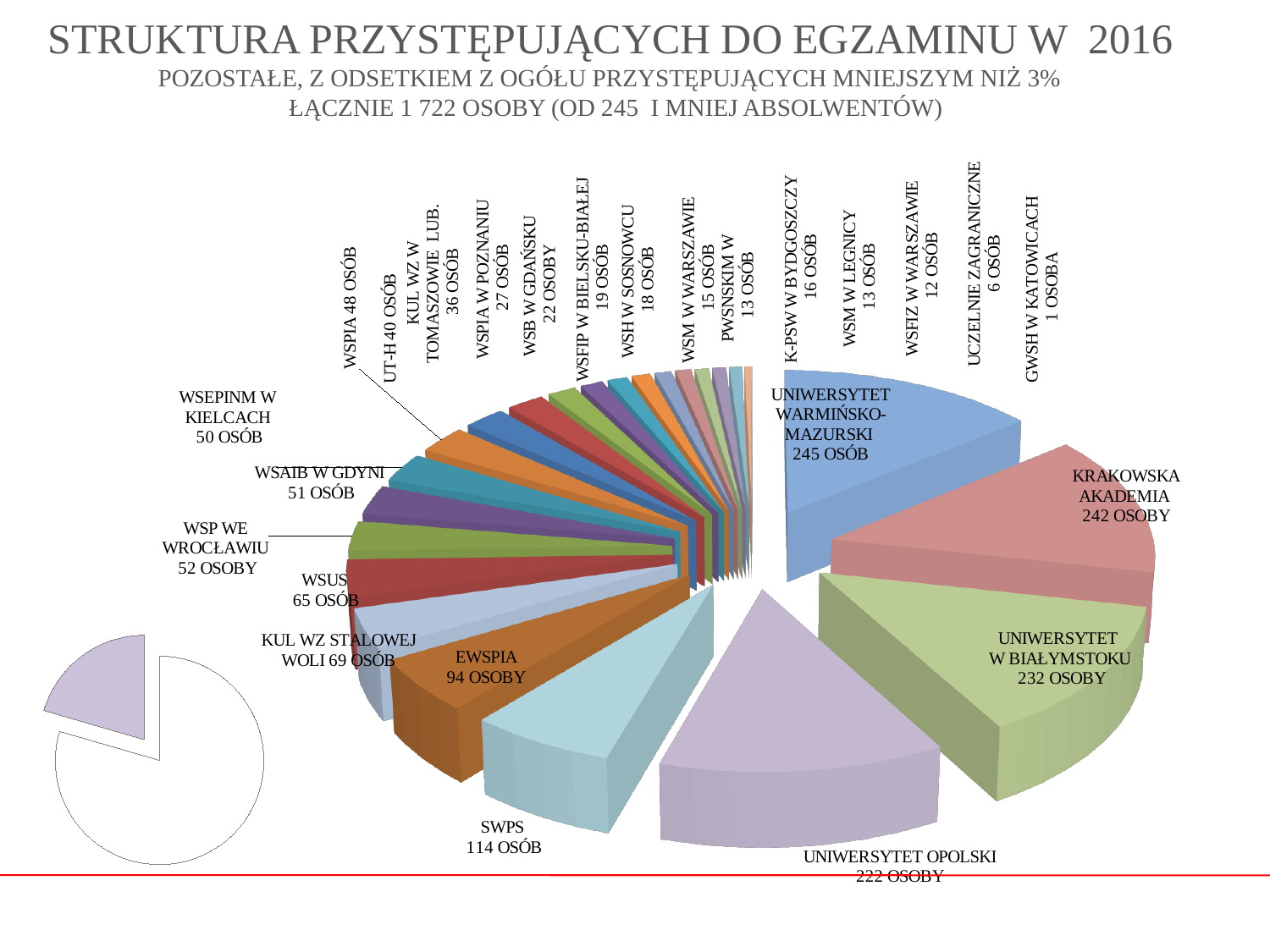
What is the difference between the values for KRAKOWSKA AKADEMIA and UNIWERSYTET OPOLSKI? 20 What is the value shown for UCZELNIE ZAGRANICZNE? 6 OSÓB How many people does the slice for UNIWERSYTET WARMIŃSKO-MAZURSKI represent? 245 OSÓB Which is larger, the value for WSUS or the value for KUL WZ STALOWEJ WOLI? KUL WZ STALOWEJ WOLI Which institution has the smallest slice of the pie? GWSH W KATOWICACH What year does the chart title refer to? 2016 How many slices does the main pie chart have? 25 What is the value shown for SWPS? 114 OSÓB Which institution has the largest slice of the pie? UNIWERSYTET WARMIŃSKO-MAZURSKI What type of chart is shown on the slide? Pie chart What is the difference between the values for SWPS and EWSPIA? 20 What is the value shown for WSB W GDAŃSKU? 22 OSOBY